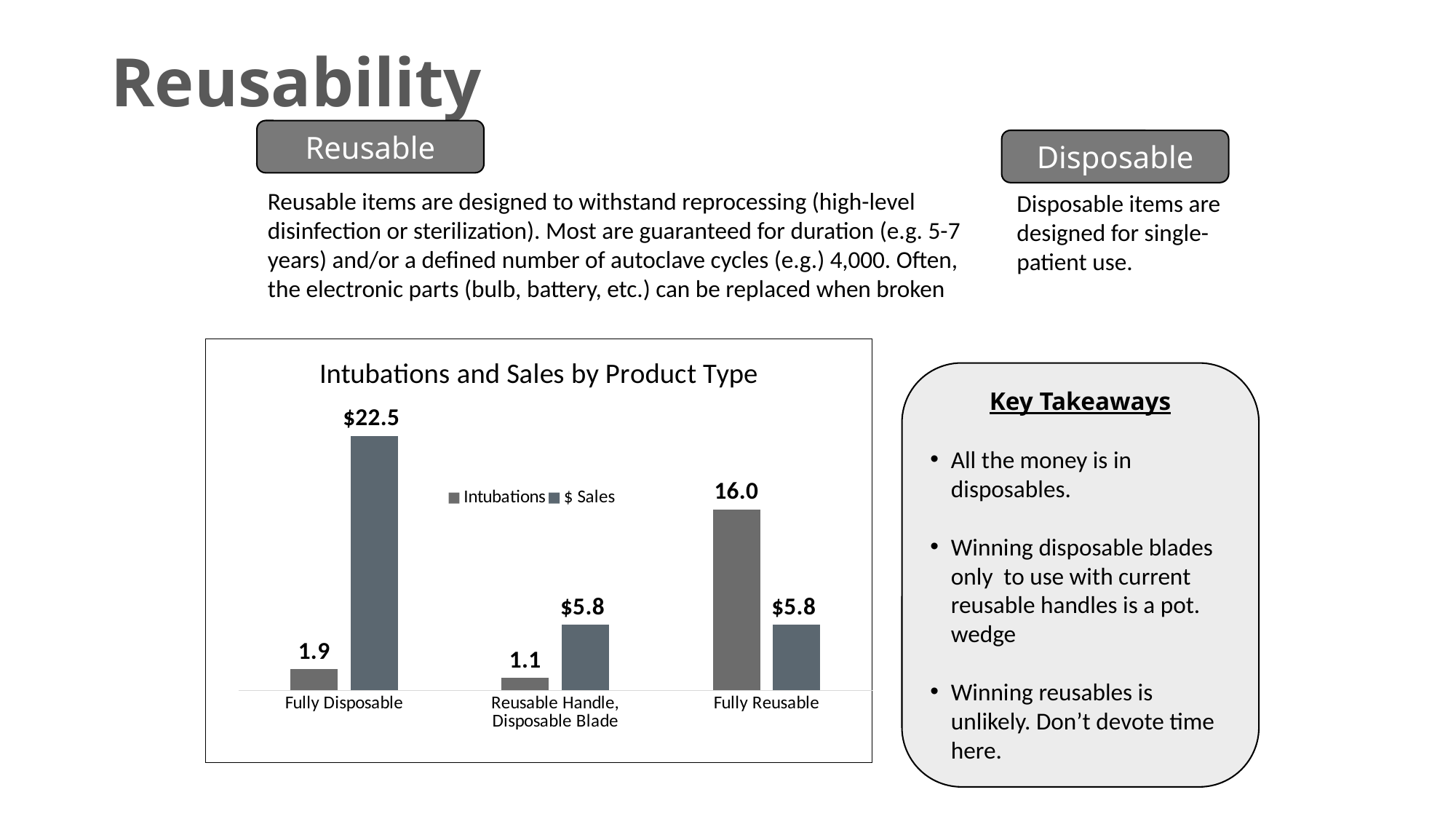
How many series does the legend list? 2 Which is larger: the Intubations value for Fully Disposable or for Reusable Handle, Disposable Blade? Fully Disposable What is the difference between the Intubations values for Fully Reusable and Fully Disposable? 14.1 Which product type has the lowest Intubations value? Reusable Handle, Disposable Blade What is the $ Sales value for Fully Reusable? $5.8 What is the $ Sales value for Fully Disposable? $22.5 What is the Intubations value for Reusable Handle, Disposable Blade? 1.1 What kind of chart is shown on the slide? Bar chart What is the Intubations value for Fully Reusable? 16.0 Which product type has the highest $ Sales value? Fully Disposable How many product type categories are shown on the x axis? 3 What is the difference between the $ Sales values for Fully Disposable and Fully Reusable? $16.7